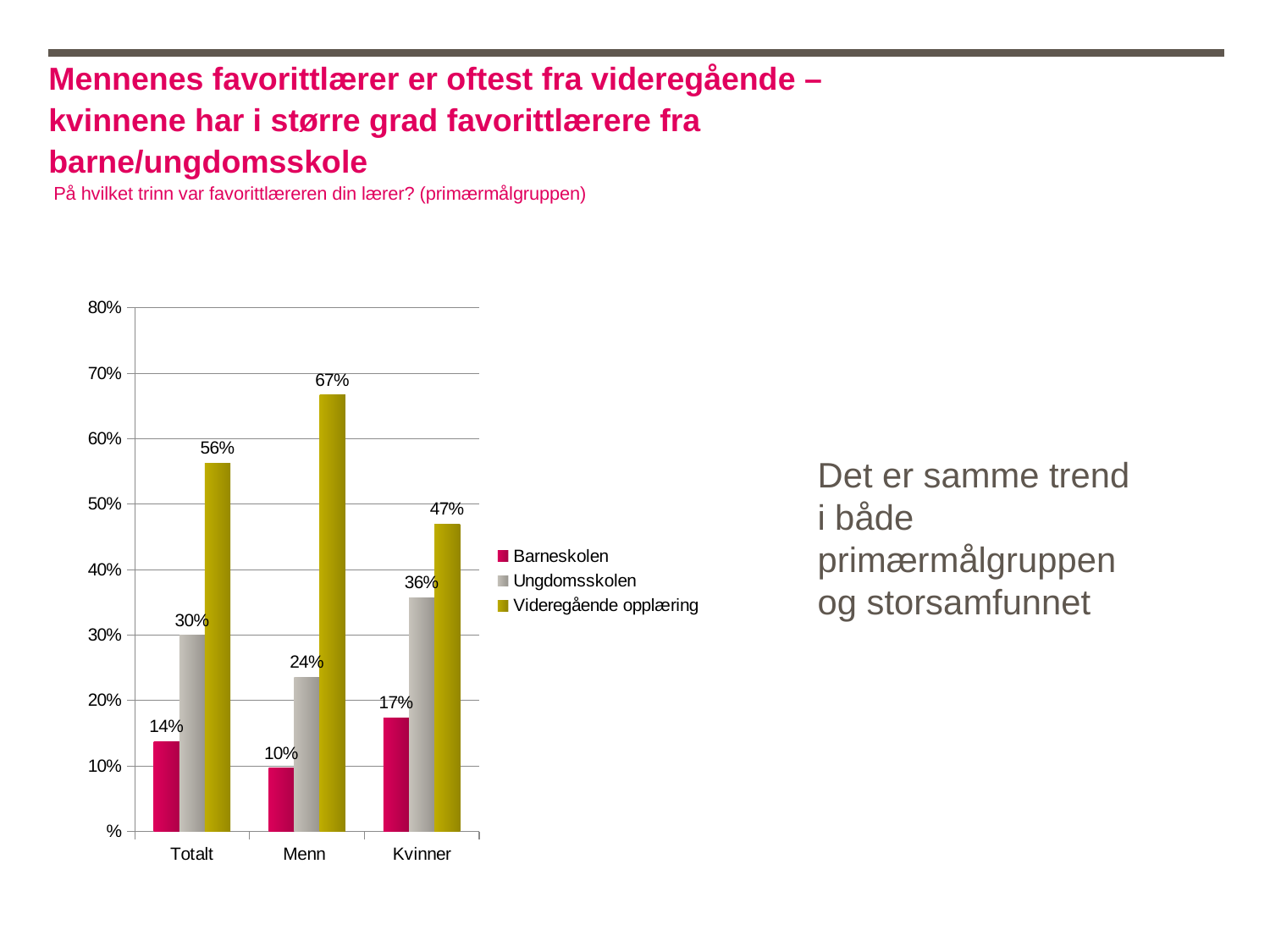
What is the value for Barneskolen in the Totalt category? 14% How many categories are shown on the x axis? 3 What kind of chart is shown on the slide? Bar chart What is the value for Ungdomsskolen in the Kvinner category? 36% How many series does the legend list? 3 Which category has the lowest value for Barneskolen? Menn Is the value for Videregående opplæring in the Totalt category greater or less than 50%? greater Which category has the highest value for Videregående opplæring? Menn What is the difference between the Videregående opplæring values for Menn and Kvinner? 20% Which series is shown in yellow-green in the legend? Videregående opplæring Which is larger: the Ungdomsskolen value for Kvinner or for Menn? Kvinner What is the value for Videregående opplæring in the Menn category? 67%